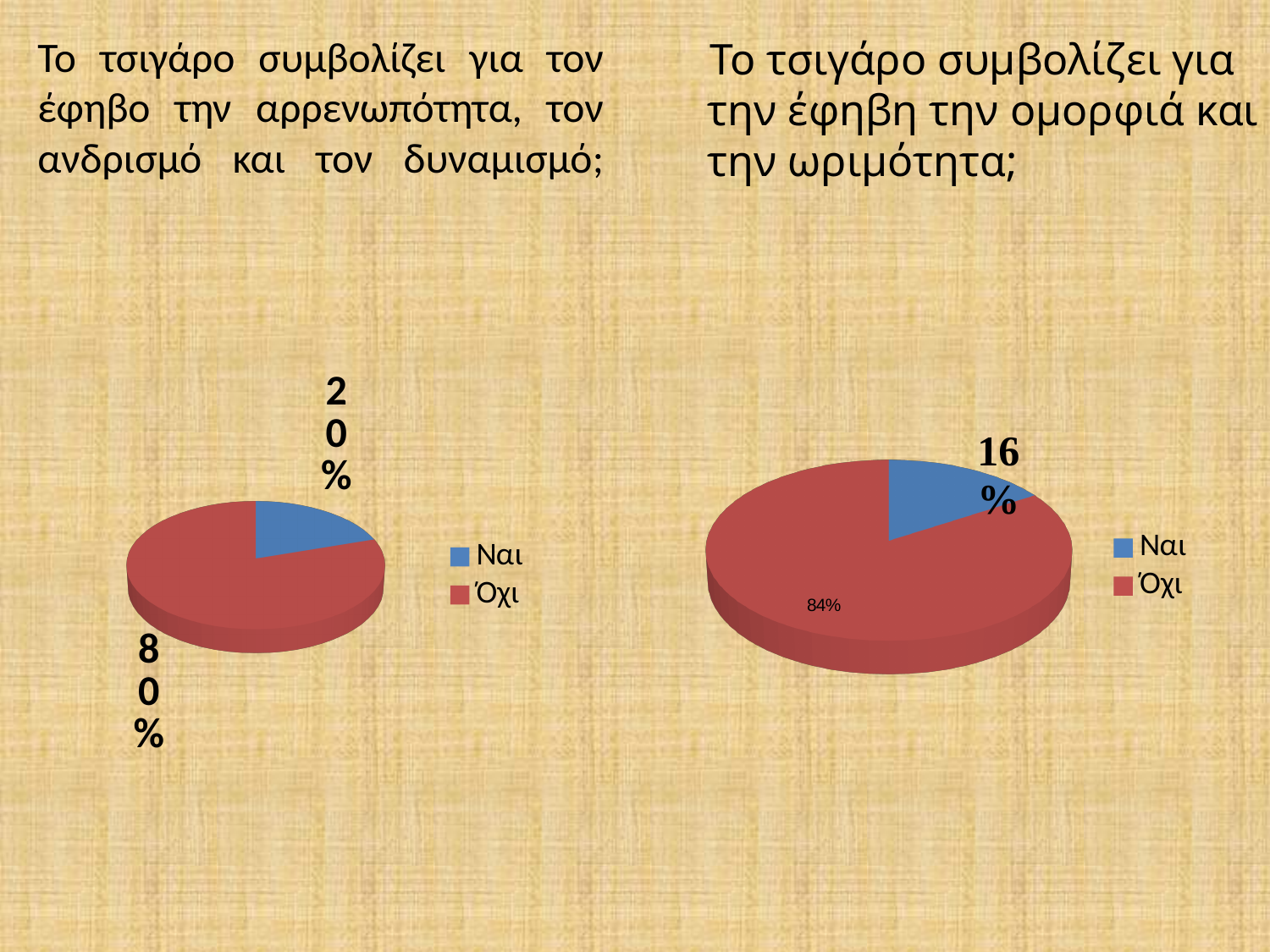
In the right pie chart, what colour represents Όχι? Red In the left pie chart, what percentage is shown for Όχι? 80% In the right pie chart, what is the difference in percentage points between Όχι and Ναι? 68 What type of chart is used on the left side of the slide? Pie chart In the left pie chart, what percentage is shown for Ναι? 20% In the right pie chart, which category has the smallest slice? Ναι Which is larger: the Ναι share in the left pie chart or the Ναι share in the right pie chart? Left pie chart How many categories does the legend of the right pie chart list? 2 In the left pie chart, which category has the largest slice? Όχι In the right pie chart, what percentage is shown for Ναι? 16% In the left pie chart, what is the difference in percentage points between Όχι and Ναι? 60 In the right pie chart, what percentage is shown for Όχι? 84%